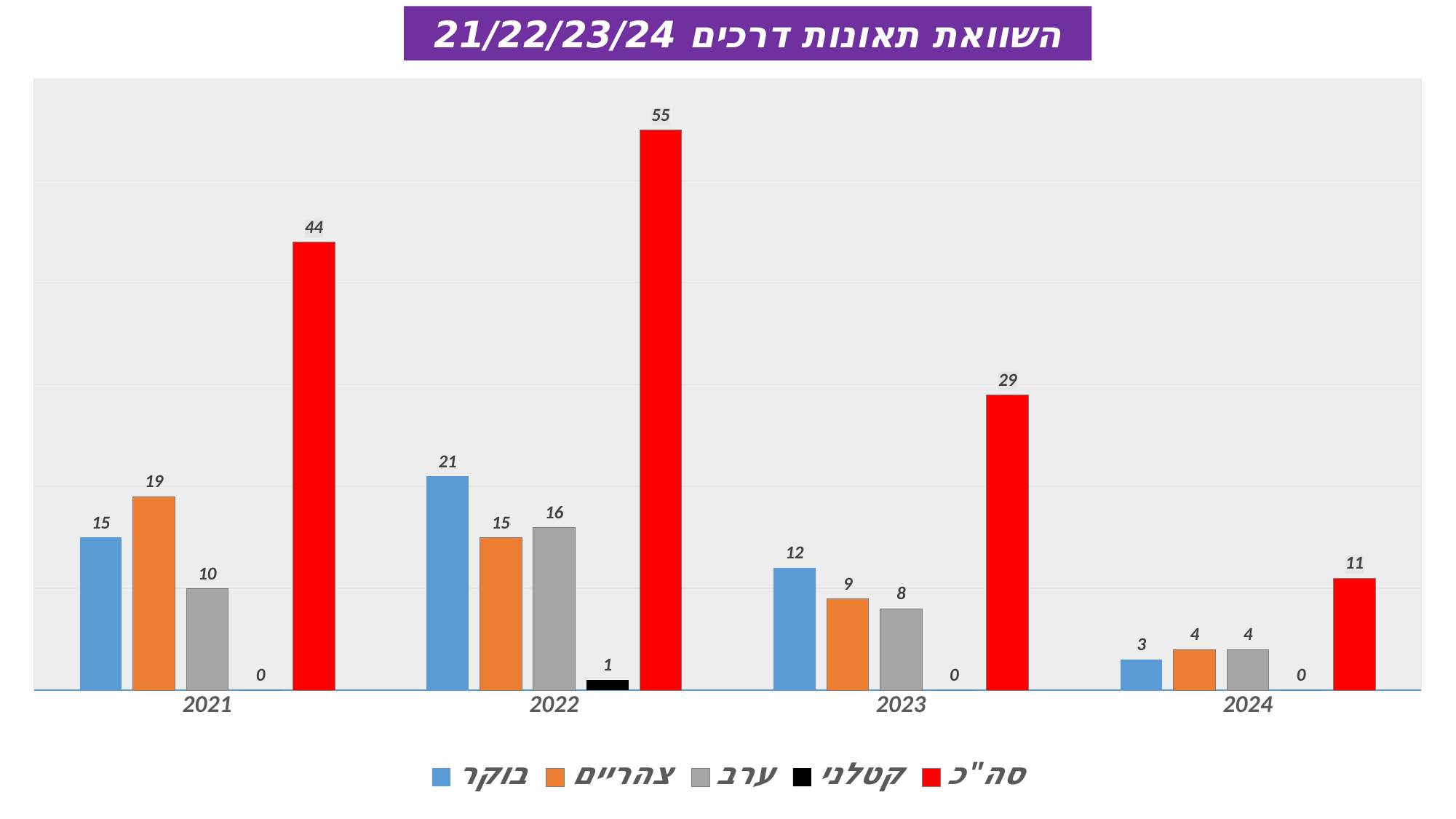
How many series does the legend list? 5 Does the סה"כ value rise or fall from 2022 to 2024? fall What is the value of ערב for 2024? 4 In which year is the בוקר value lowest? 2024 What kind of chart is shown on the slide? bar chart What is the difference between the סה"כ values for 2021 and 2023? 15 In which year is the סה"כ value highest? 2022 What is the value of בוקר for 2021? 15 What is the value of סה"כ for 2022? 55 What is the value of קטלני for 2022? 1 Which is larger in 2022: בוקר or ערב? בוקר How many years are shown on the x axis? 4